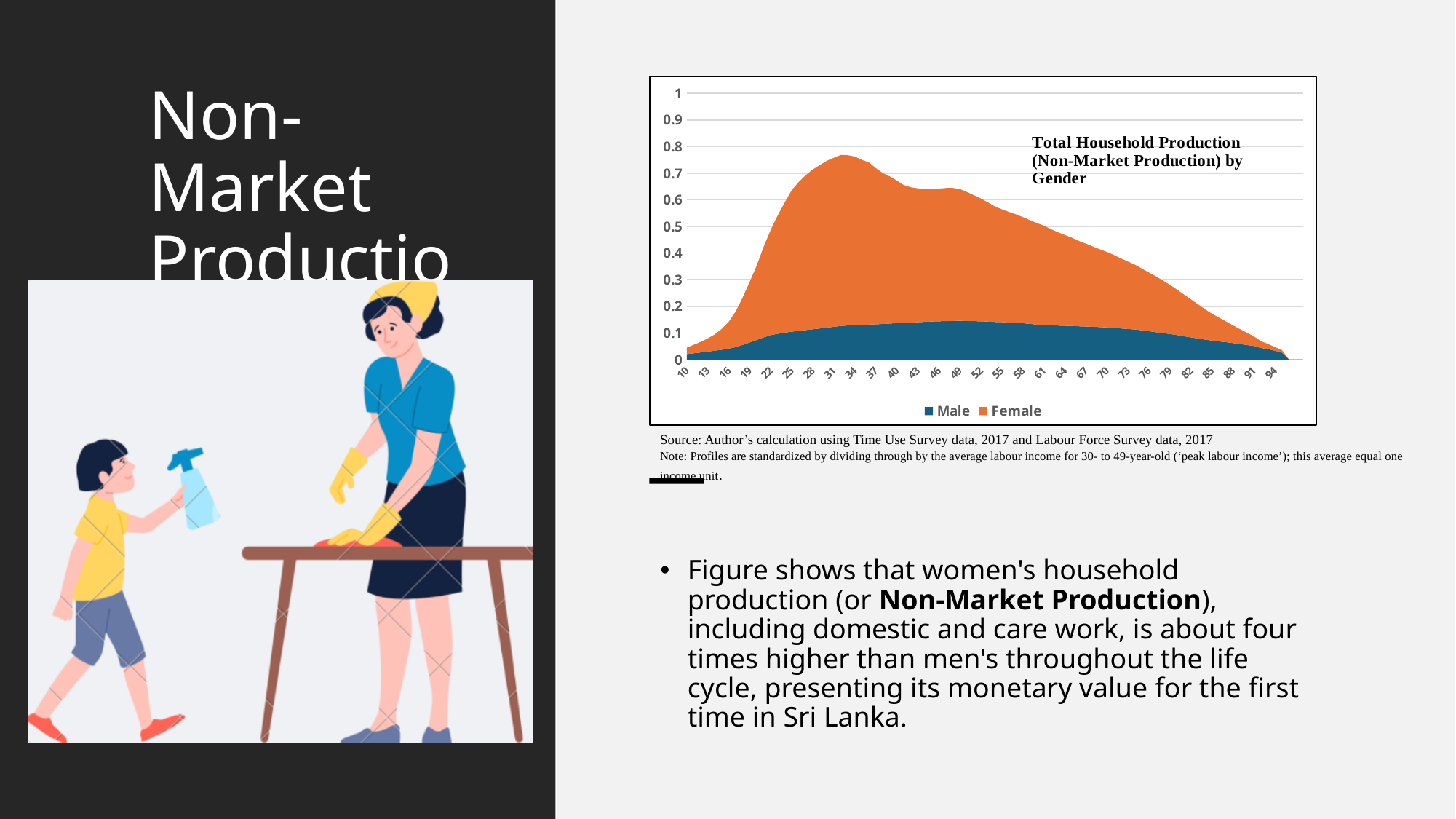
How many age labels are shown on the x axis of the chart? 29 Is the total household production value at age 10 greater or less than 0.1? less What are the two series named in the chart legend? Male and Female Is the total household production value at age 82 greater or less than 0.3? less Which series is larger at age 40, Male or Female? Female What is the title of the chart? Total Household Production (Non-Market Production) by Gender Is the total household production value at age 31 greater or less than 0.7? greater What is the highest value shown on the y axis of the chart? 1 What kind of chart is shown on the slide? Area chart How many series does the chart legend list? 2 Does the total household production value rise or fall along the x axis from age 34 to age 94? Fall